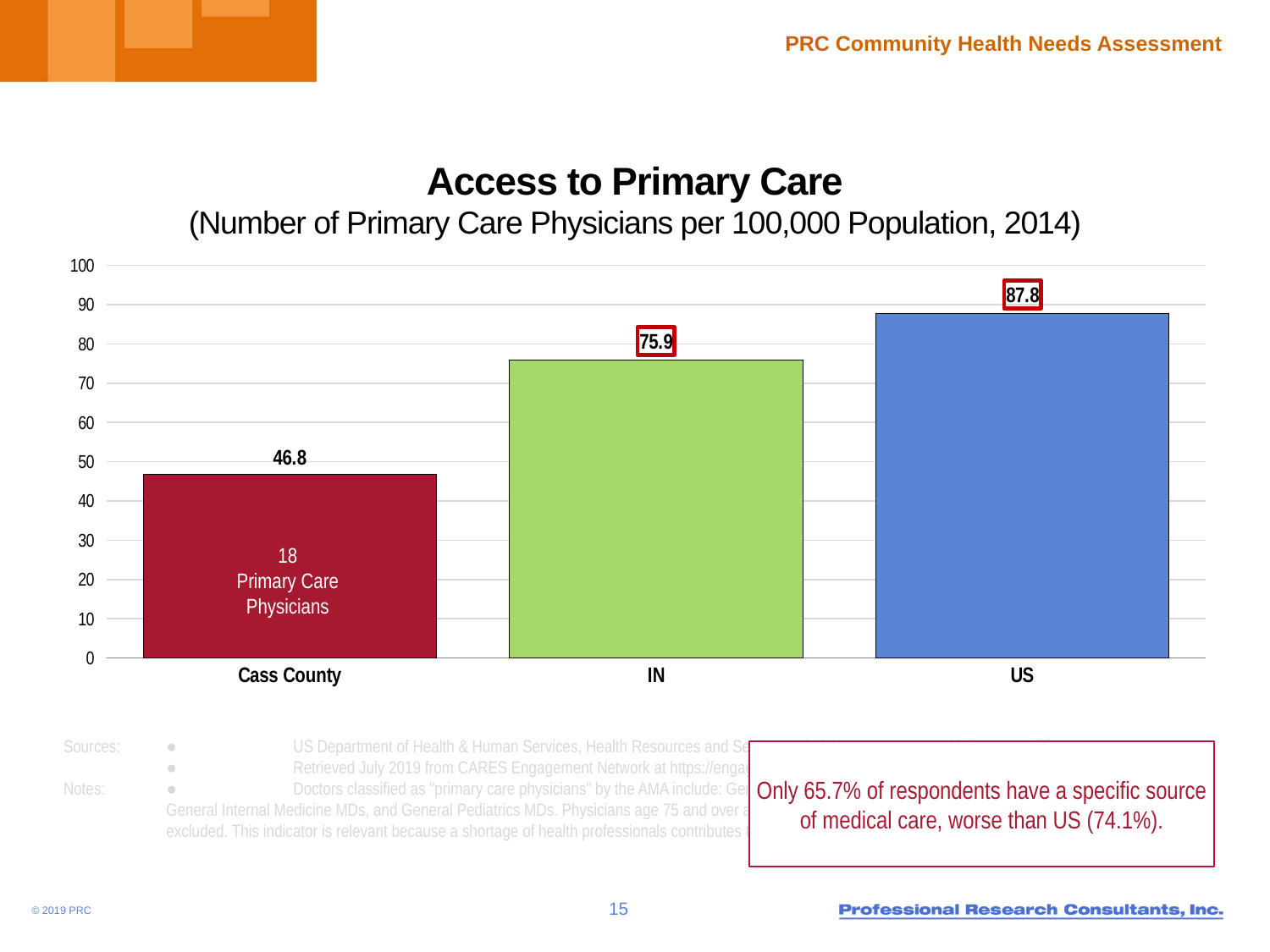
Which category has the highest value? US How many categories are shown on the x axis? 3 What kind of chart is shown on the slide? bar chart How many primary care physicians does the label inside the Cass County bar report? 18 Which category has the lowest value? Cass County What is the difference between the IN value and the Cass County value? 29.1 What is the value for Cass County? 46.8 Is the value for Cass County greater or less than 50? less What is the value for IN? 75.9 What is the value for US? 87.8 Which is larger, the value for IN or the value for US? US What is the difference between the US value and the Cass County value? 41